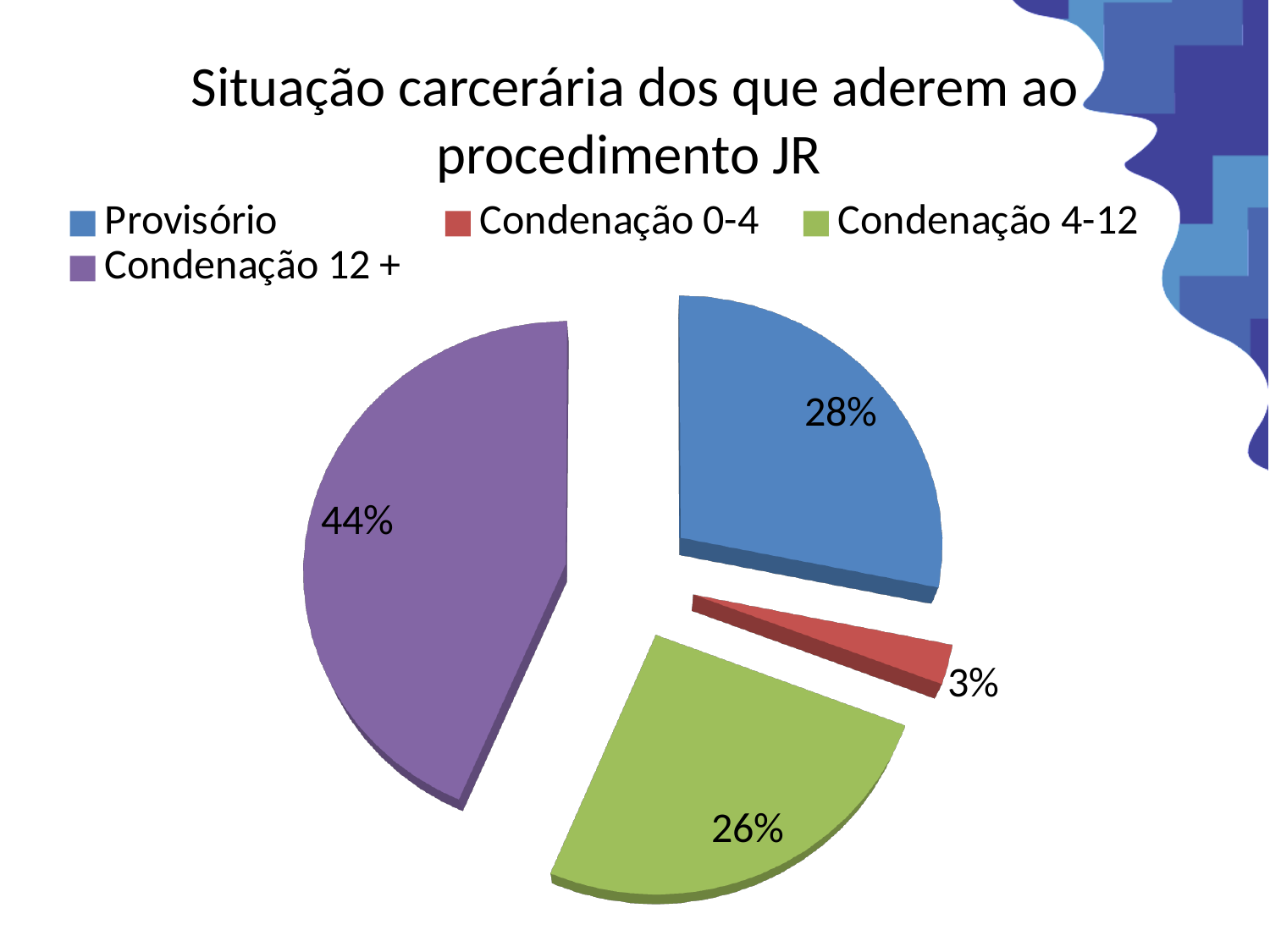
What is the title of the chart? Situação carcerária dos que aderem ao procedimento JR How many categories does the pie chart show? 4 What kind of chart is shown on the slide? Pie chart What share of the pie does Condenação 0-4 represent? 3% What is the difference in percentage points between Condenação 12 + and Provisório? 16 What colour is the slice for Condenação 4-12? Green What share of the pie does Provisório represent? 28% Which category has the largest slice of the pie? Condenação 12 + What share of the pie does Condenação 4-12 represent? 26% Which category has the smallest slice of the pie? Condenação 0-4 Which is larger, the share for Provisório or the share for Condenação 4-12? Provisório